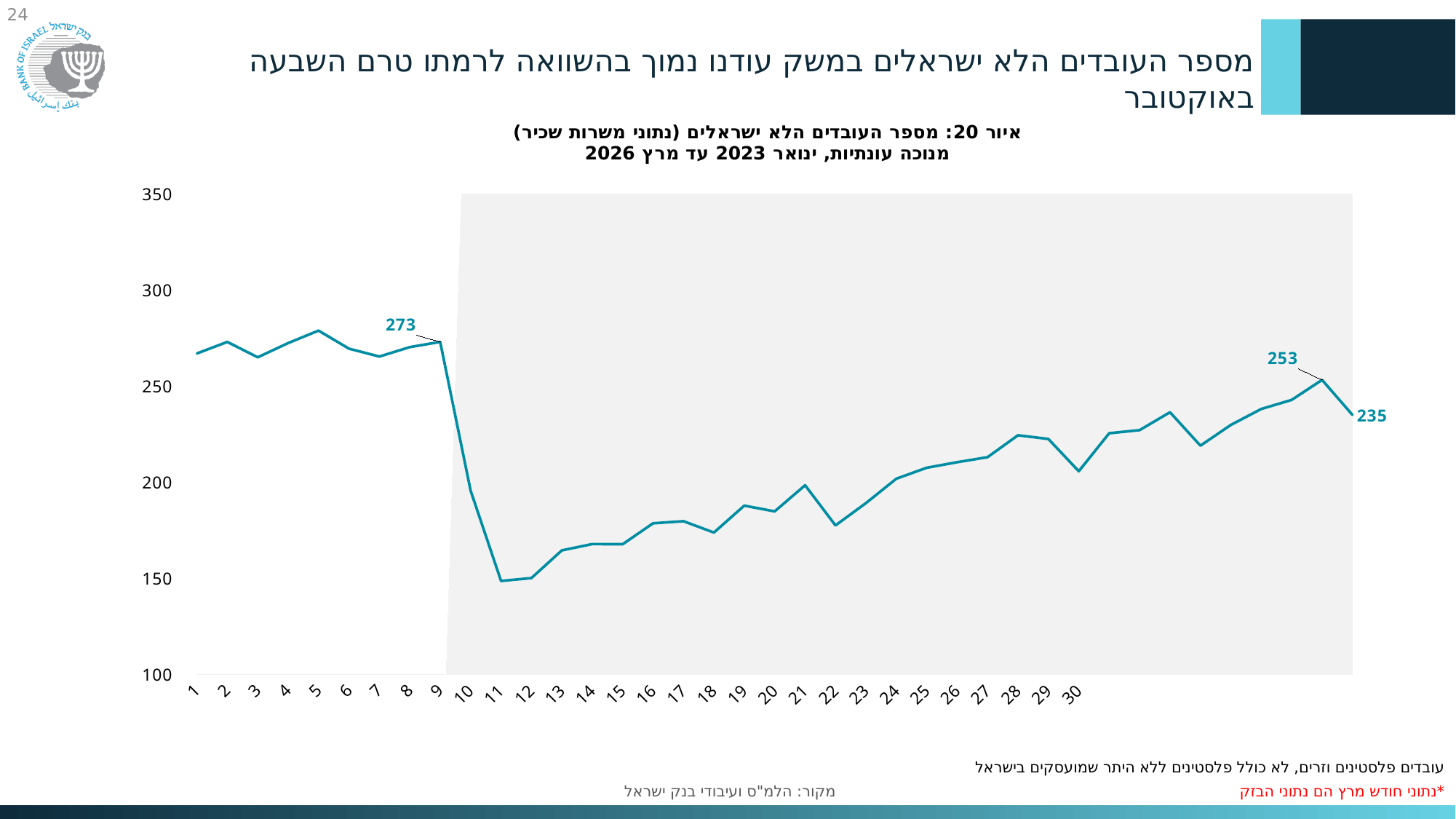
Which is larger: the labelled value at point 9 or the labelled value at the final point? point 9 (273) What is the highest value shown on the y axis? 350 What is the value labelled at point 9, just before the sharp drop? 273 Is the value at point 28 greater or less than 250? less What is the value labelled at the peak just before the final point? 253 What is the difference between the labelled value 273 and the final labelled value 235? 38 What kind of chart is shown on the slide? line chart What is the difference between the labelled values 253 and 235? 18 What is the value labelled at the last point of the line? 235 Is the value at point 5 greater or less than 250? greater From point 11 to point 28, do the values generally rise or fall? rise Is the value at point 11 greater or less than 200? less